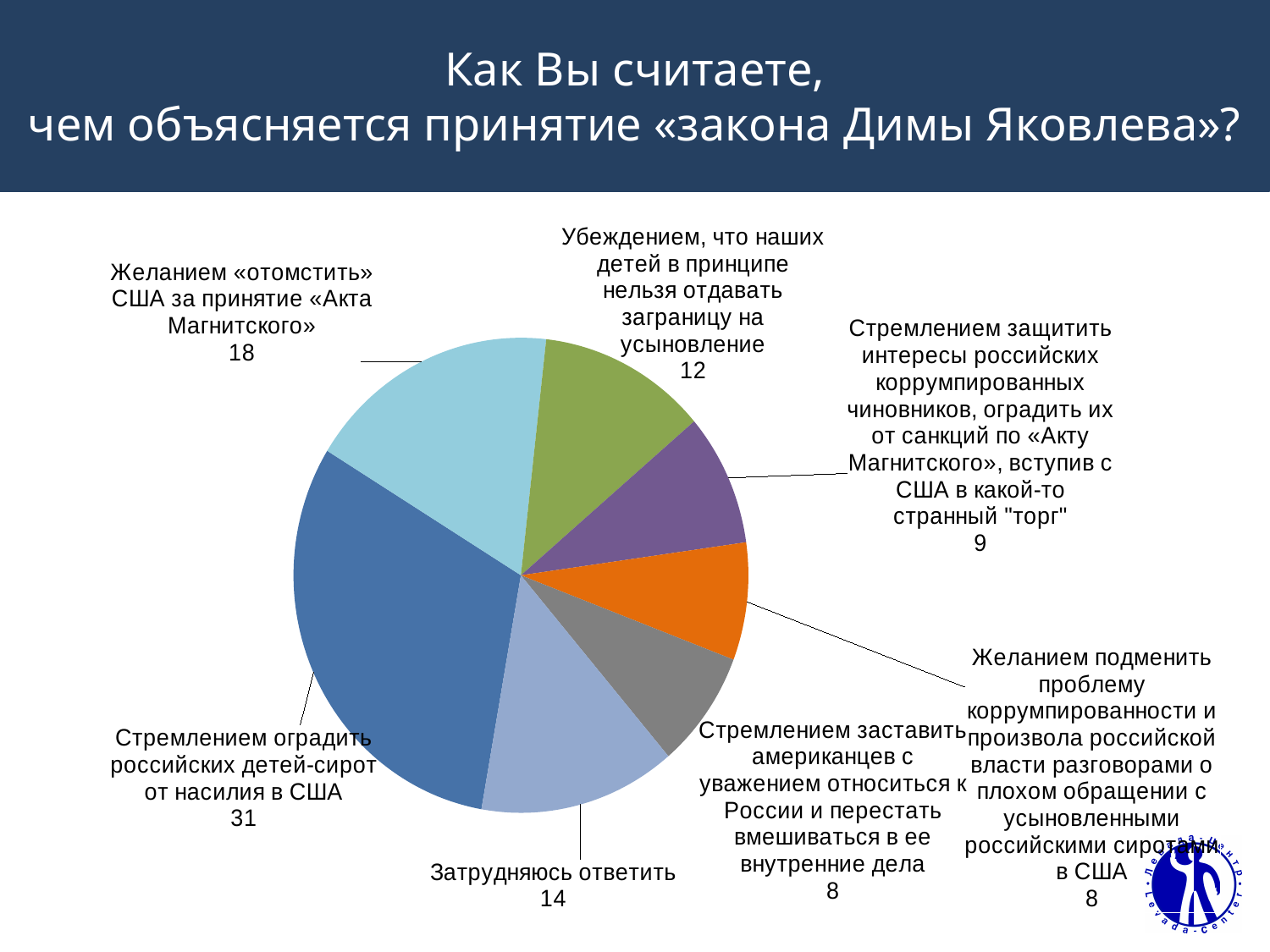
Which is larger: the value for «Затрудняюсь ответить» or the value for «Убеждением, что наших детей в принципе нельзя отдавать заграницу на усыновление»? Затрудняюсь ответить What is the total of all the values shown on the pie chart? 100 What share of the pie does «Стремлением оградить российских детей-сирот от насилия в США» represent? 31% What is the value for «Убеждением, что наших детей в принципе нельзя отдавать заграницу на усыновление»? 12 How many slices does the pie chart have? 7 What is the value for «Желанием «отомстить» США за принятие «Акта Магнитского»»? 18 Which category has the largest slice of the pie? Стремлением оградить российских детей-сирот от насилия в США What is the difference between the value for «Стремлением оградить российских детей-сирот от насилия в США» and the value for «Желанием «отомстить» США за принятие «Акта Магнитского»»? 13 What type of chart is shown on the slide? pie chart What is the value for «Затрудняюсь ответить»? 14 What is the value for «Стремлением оградить российских детей-сирот от насилия в США»? 31 What is the title of the slide? Как Вы считаете, чем объясняется принятие «закона Димы Яковлева»?